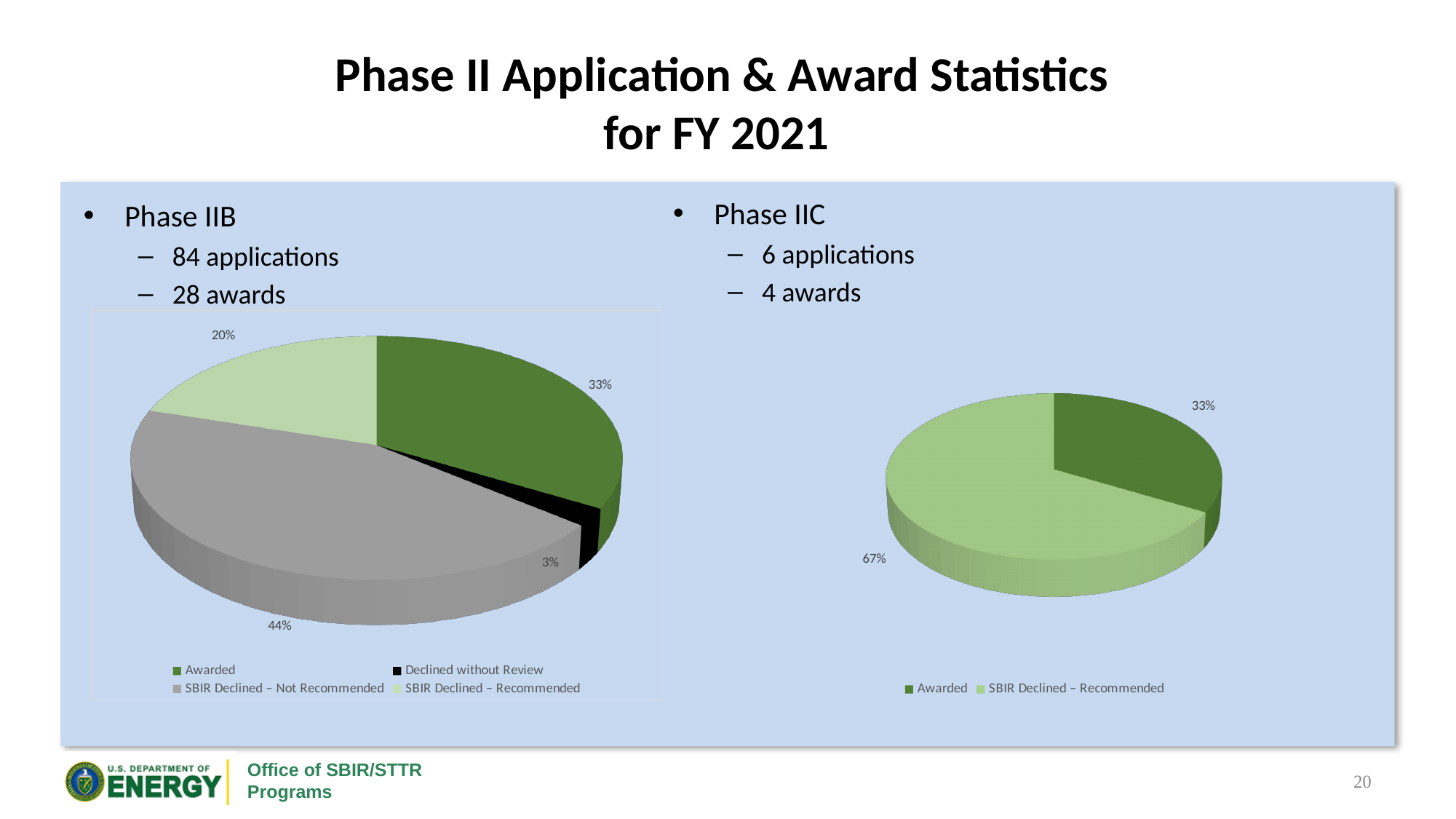
In the left pie chart (Phase IIB), what is the difference in percentage points between SBIR Declined – Not Recommended and Awarded? 11 In the left pie chart (Phase IIB), which category has the largest slice? SBIR Declined – Not Recommended In the right pie chart (Phase IIC), which is larger, Awarded or SBIR Declined – Recommended? SBIR Declined – Recommended In the left pie chart (Phase IIB), what share is labelled for SBIR Declined – Recommended? 20% What type of chart is used on the right side of the slide (Phase IIC)? Pie chart In the left pie chart (Phase IIB), which category has the smallest slice? Declined without Review In the left pie chart (Phase IIB), how many categories does the legend list? 4 In the right pie chart (Phase IIC), what share is labelled for Awarded? 33% In the left pie chart (Phase IIB), what share is labelled for Declined without Review? 3%